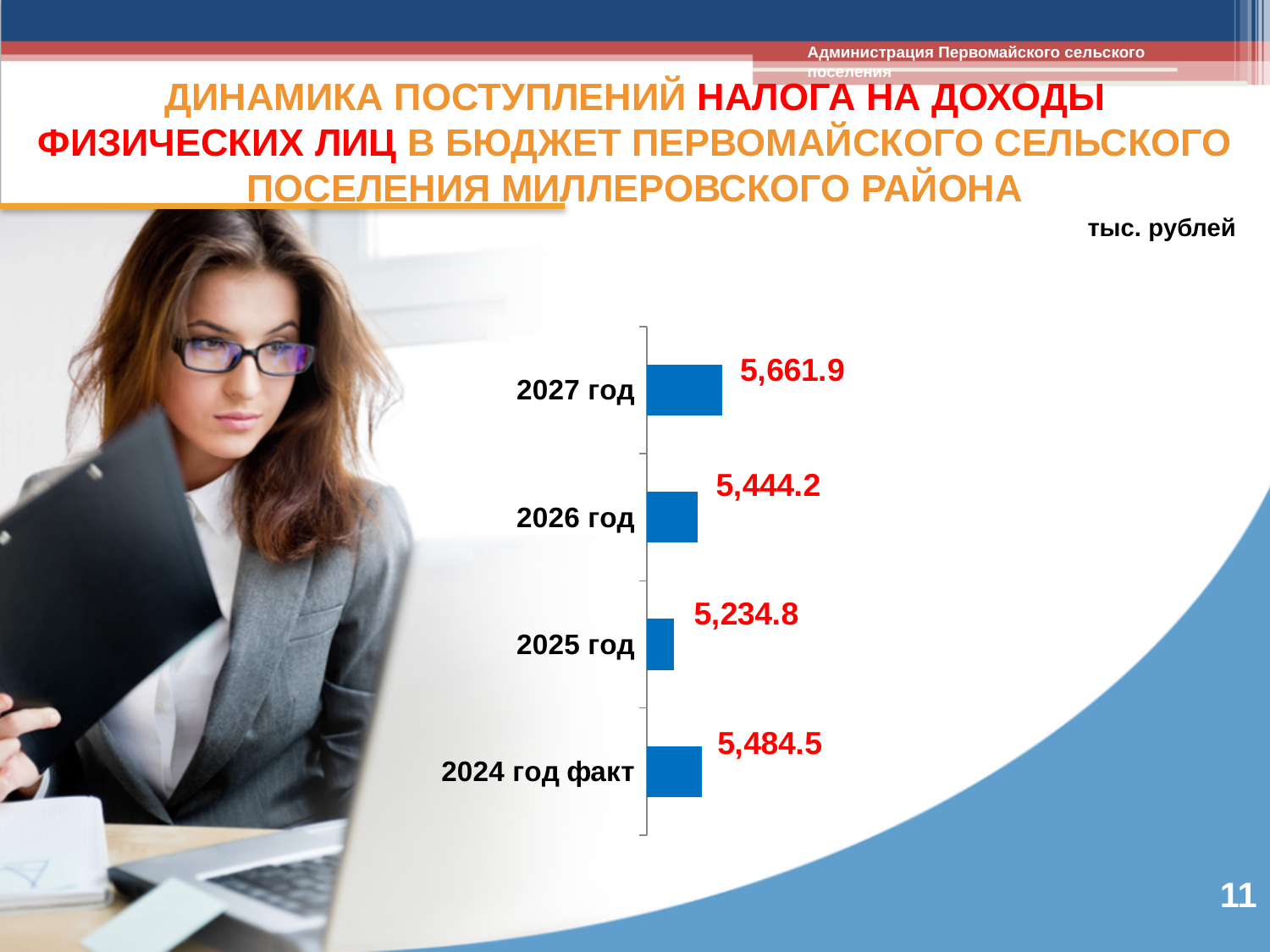
Which year has the lowest value? 2025 год In what units are the chart values given? тыс. рублей What is the difference between the values for 2027 год and 2025 год? 427.1 What kind of chart is shown on the slide? bar chart What is the value for 2024 год факт? 5,484.5 Which year has the highest value? 2027 год What is the value for 2025 год? 5,234.8 What is the difference between the values for 2024 год факт and 2025 год? 249.7 How many years are shown in the chart? 4 What is the value for 2026 год? 5,444.2 What is the value for 2027 год? 5,661.9 Which is larger, the value for 2024 год факт or the value for 2026 год? 2024 год факт